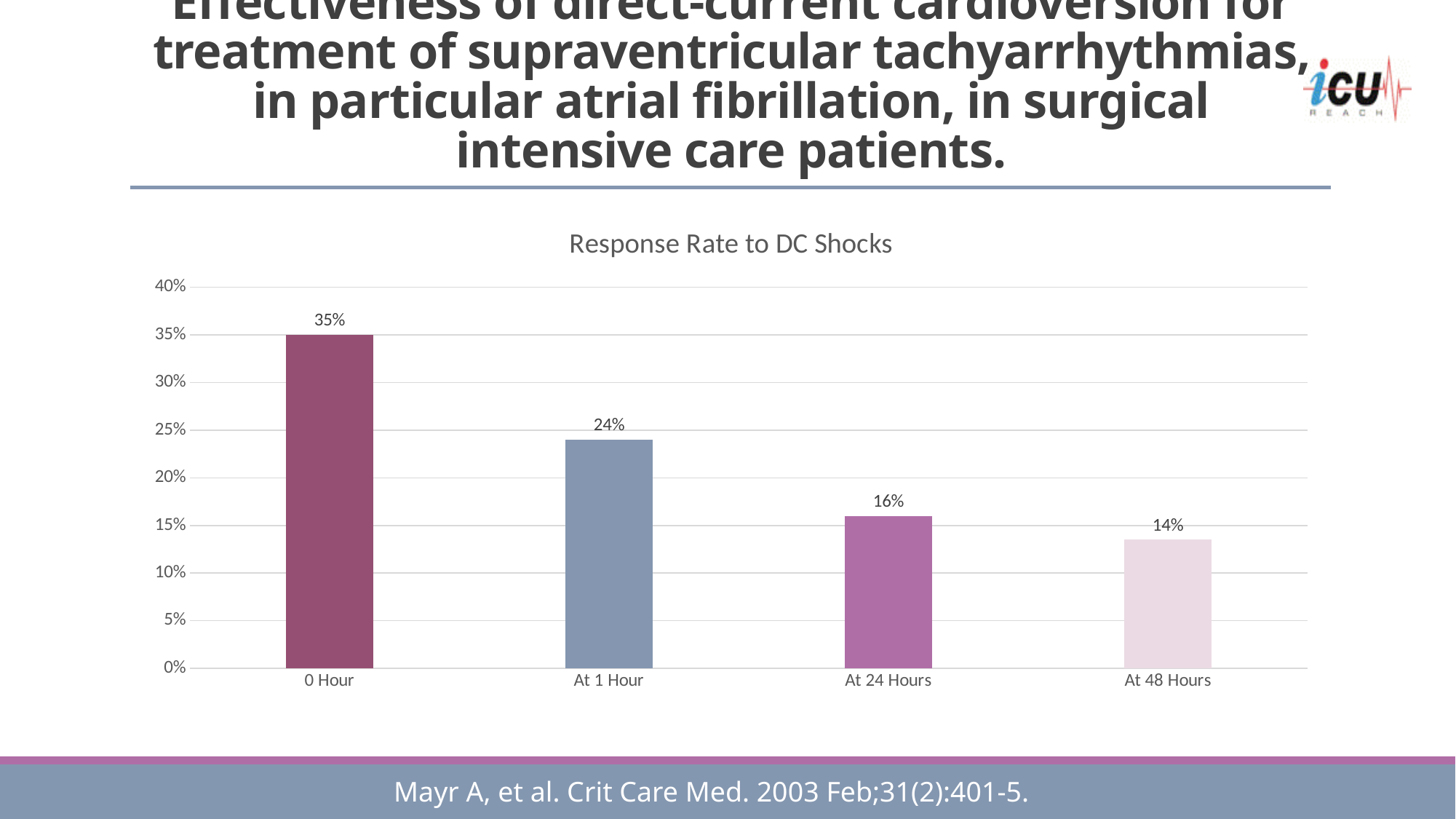
Do the response rates rise or fall from 0 Hour to 48 Hours? Fall What is the response rate at 0 Hour? 35% How many time points are shown in the chart? 4 Which is larger, the response rate at 1 Hour or at 24 Hours? At 1 Hour What is the difference between the response rate at 0 Hour and at 1 Hour? 11% What is the response rate at 24 Hours? 16% What is the response rate at 1 Hour? 24% What is the response rate at 48 Hours? 14% Which time point has the lowest response rate? At 48 Hours Which time point has the highest response rate? 0 Hour What kind of chart is shown on the slide? Bar chart Is the response rate at 24 Hours greater or less than 20%? less